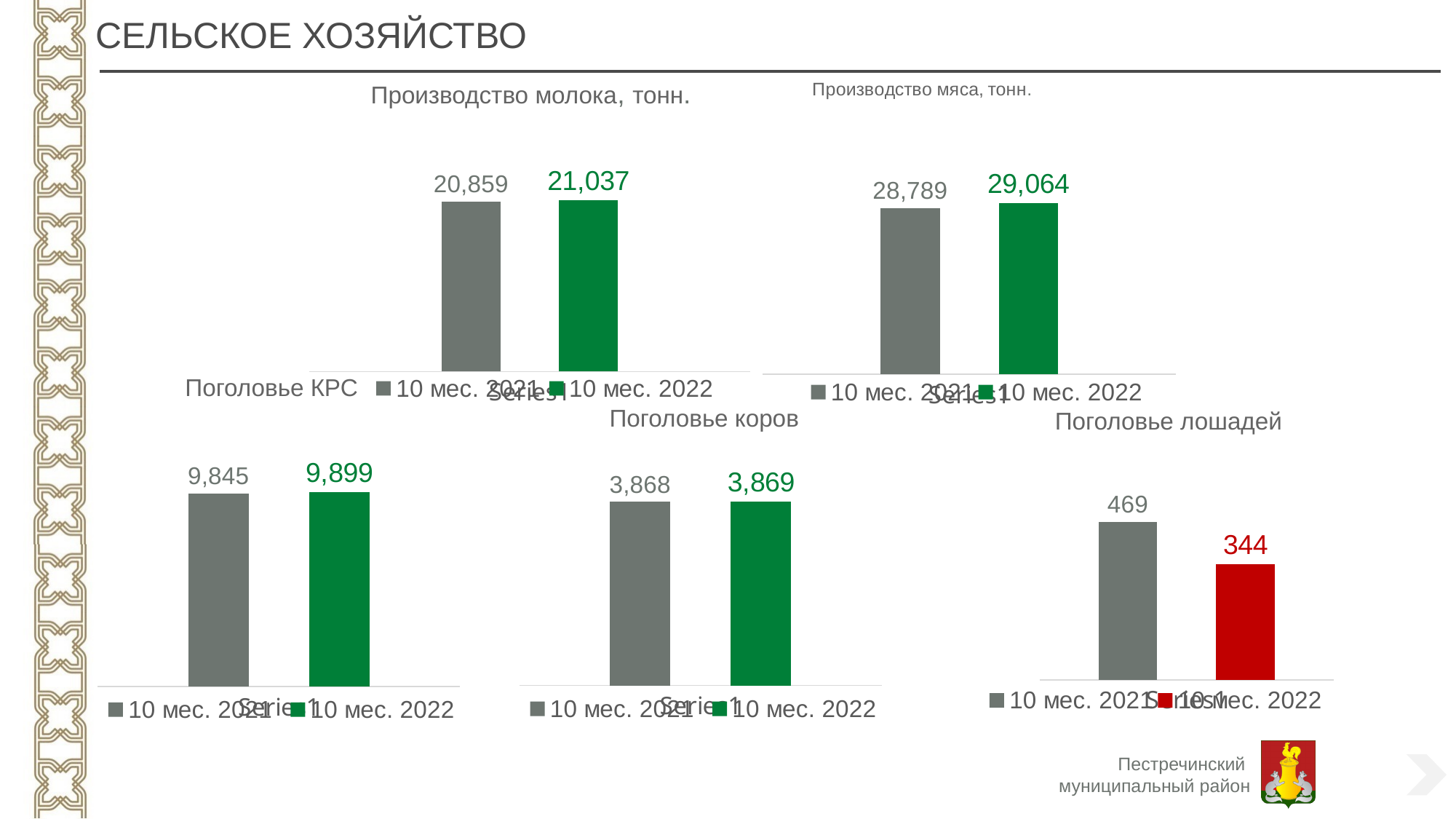
In the 'Поголовье лошадей' chart, what is the difference between the 10 мес. 2021 and 10 мес. 2022 values? 125 In the 'Производство мяса, тонн.' chart, what is the value for 10 мес. 2022? 29,064 What type of chart is the 'Поголовье лошадей' chart? Bar chart In the 'Производство молока, тонн.' chart, what is the value for 10 мес. 2021? 20,859 In the 'Поголовье лошадей' chart, what is the value for 10 мес. 2022? 344 How many series does the legend of the 'Производство молока, тонн.' chart list? 2 In the 'Поголовье КРС' chart, what is the value for 10 мес. 2021? 9,845 In the 'Поголовье КРС' chart, what is the difference between the 10 мес. 2022 and 10 мес. 2021 values? 54 In the 'Производство мяса, тонн.' chart, what is the difference between the 10 мес. 2022 and 10 мес. 2021 values? 275 In the 'Поголовье коров' chart, what is the value for 10 мес. 2022? 3,869 In the 'Производство молока, тонн.' chart, what is the value for 10 мес. 2022? 21,037 In the 'Поголовье лошадей' chart, which period has the lower value? 10 мес. 2022